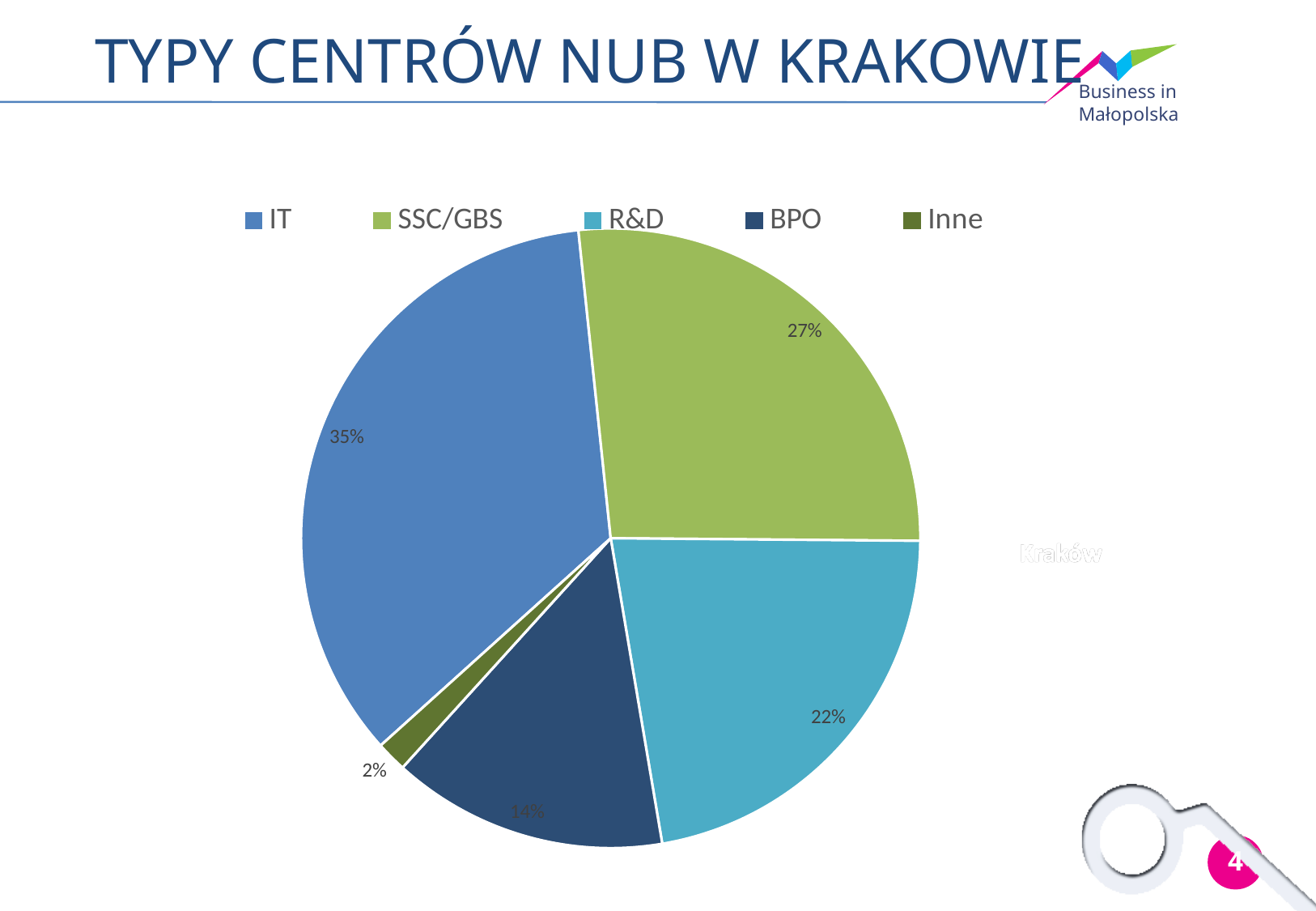
Which is larger, the share for SSC/GBS or the share for R&D? SSC/GBS What share of the pie does R&D have? 22% What is the difference in percentage points between IT and BPO? 21 What kind of chart is shown on the slide? Pie chart What share of the pie does IT have? 35% What share of the pie does Inne have? 2% What share of the pie does SSC/GBS have? 27% What is the title of the slide? TYPY CENTRÓW NUB W KRAKOWIE What share of the pie does BPO have? 14% Which category has the smallest slice of the pie? Inne How many categories does the pie chart show? 5 Which category has the largest slice of the pie? IT